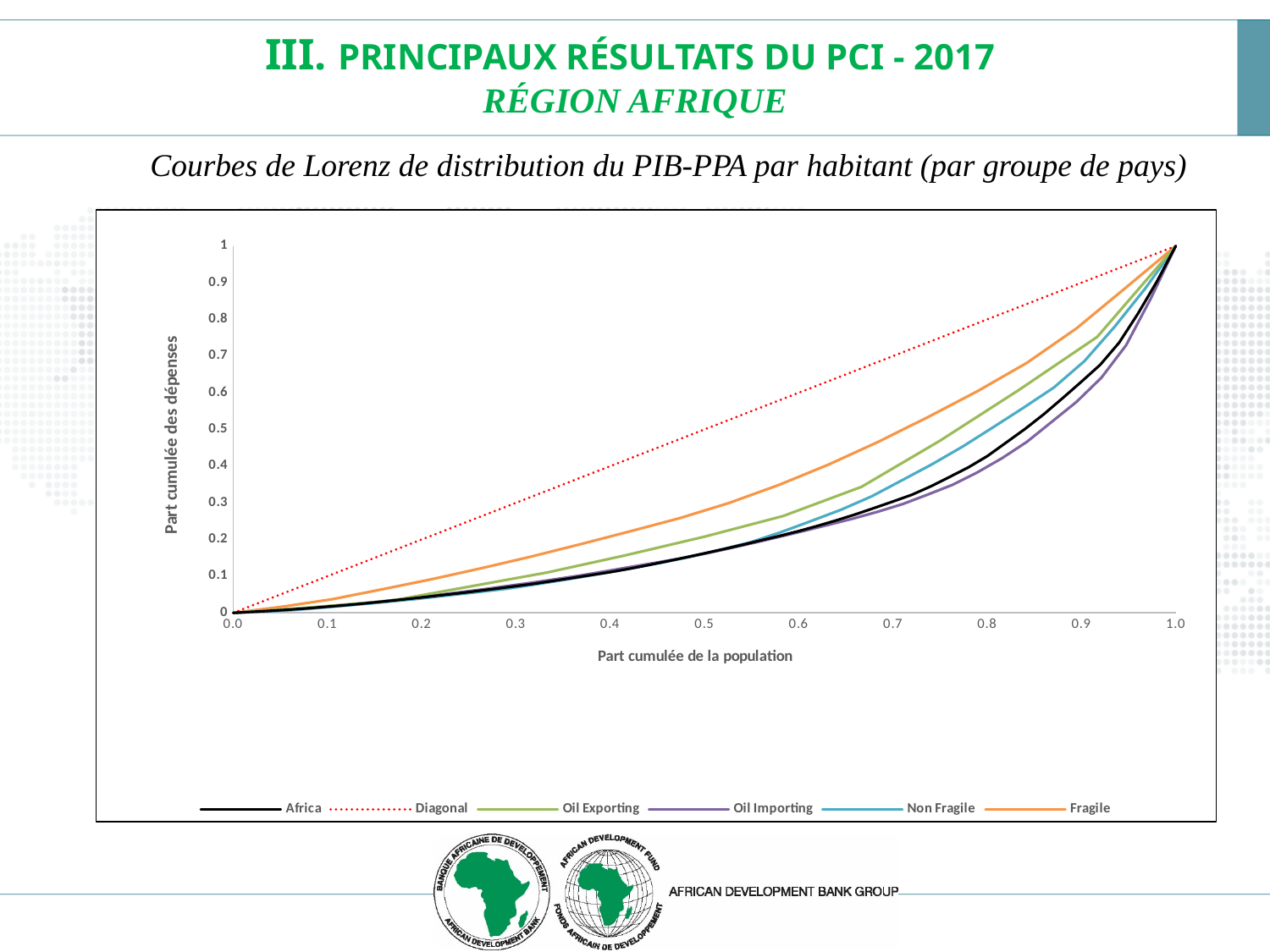
Which legend entry is drawn as a red dotted line? Diagonal At a population share of 0.8, which curve is higher: Fragile or Africa? Fragile Is the value of the Non Fragile curve at a population share of 0.9 greater or less than 0.6? greater Do the curves rise or fall as the cumulative population share increases along the x axis? rise What is the title of the y axis? Part cumulée des dépenses What kind of chart is shown on the slide? line chart Excluding the Diagonal, which curve is highest at a population share of 0.7? Fragile Is the value of the Fragile curve at a population share of 0.5 greater or less than 0.2? greater How many tick labels are shown on the x axis? 11 Is the value of the Fragile curve at a population share of 0.7 greater or less than 0.3? greater How many series does the legend list? 6